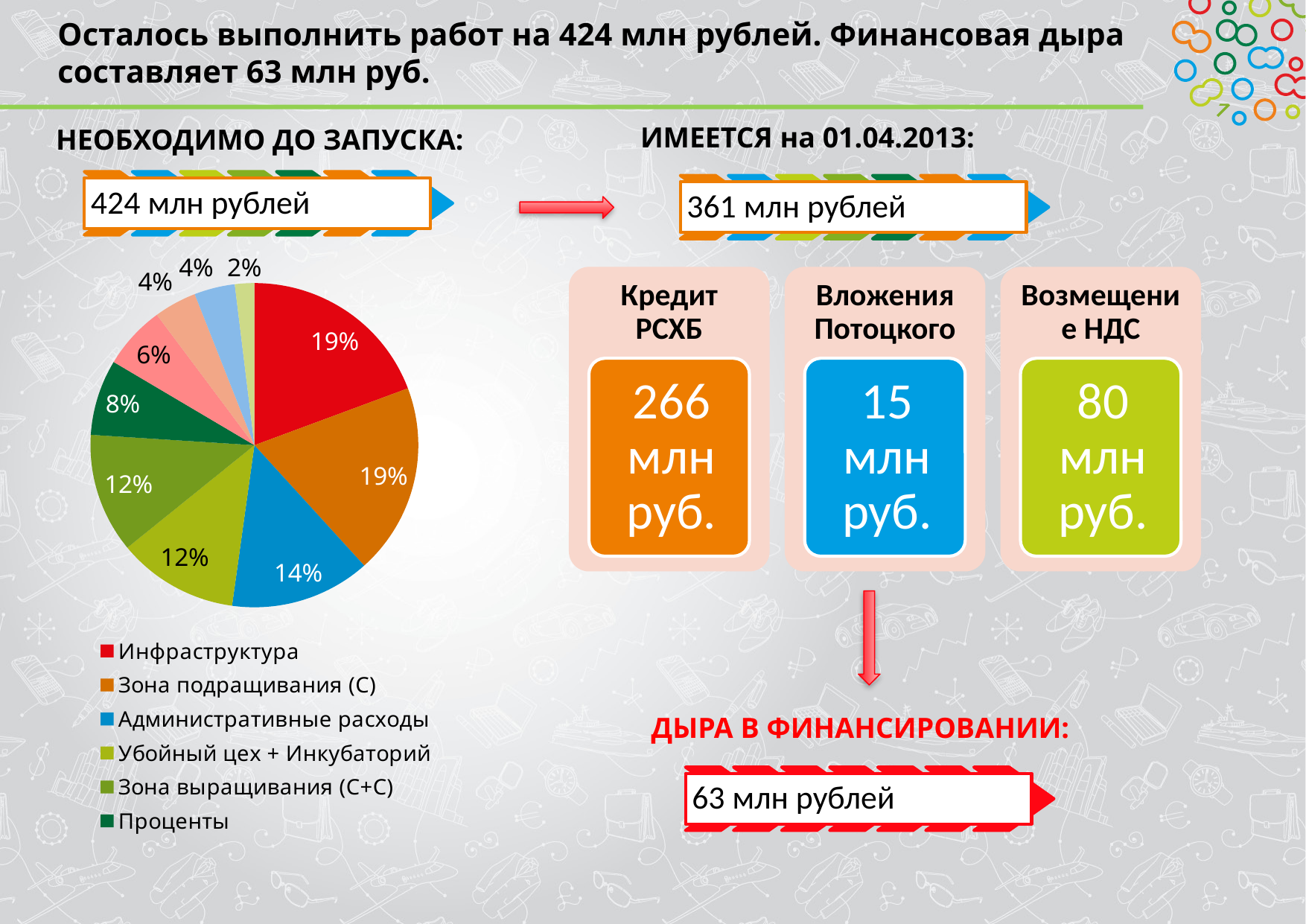
Which is larger in the pie chart: Административные расходы or Проценты? Административные расходы How many entries does the pie chart's legend list? 6 What share of the pie chart does Административные расходы take? 14% What kind of chart is shown on the left of the slide? pie chart What share of the pie chart does Убойный цех + Инкубаторий take? 12% What share of the pie chart does Зона подращивания (С) take? 19% What colour is the Инфраструктура slice in the pie chart? red What is the smallest percentage shown on the pie chart? 2% How many slices does the pie chart have? 10 By how many percentage points does Инфраструктура exceed Проценты in the pie chart? 11